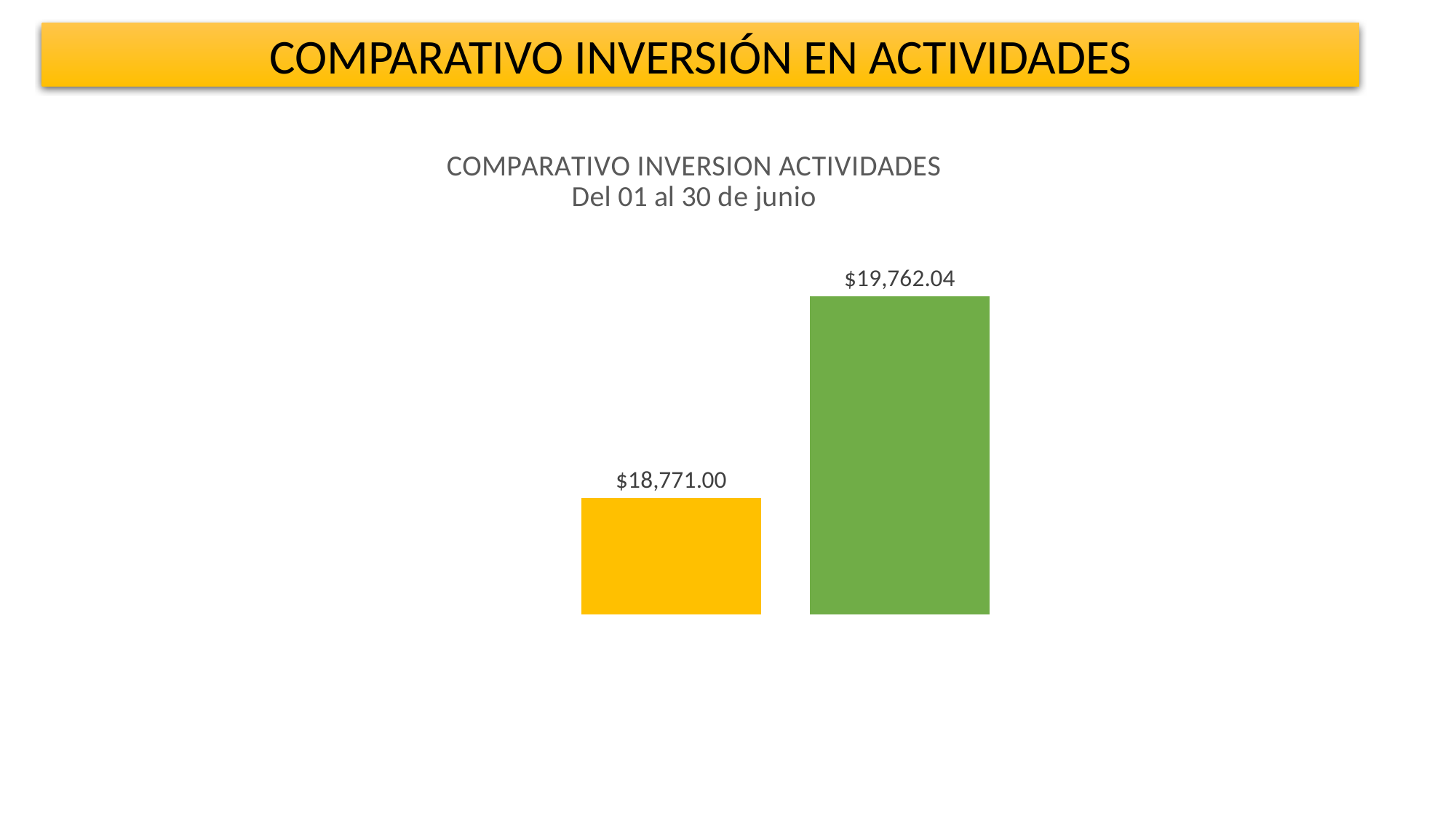
What is the value of the left bar? $18,771.00 What period is named in the chart's title? Del 01 al 30 de junio What value is printed on the yellow bar? $18,771.00 What is the value of the right bar? $19,762.04 Which bar has the highest value, the yellow one or the green one? the green one How many bars are plotted in the chart? 2 What is the difference between the green bar's value and the yellow bar's value? $991.04 Is the value of the left bar larger or smaller than the value of the right bar? smaller What kind of chart is shown on the slide? bar chart What value is printed on the green bar? $19,762.04 Do the bar values rise or fall from left to right? rise Which bar has the lowest value, the yellow one or the green one? the yellow one